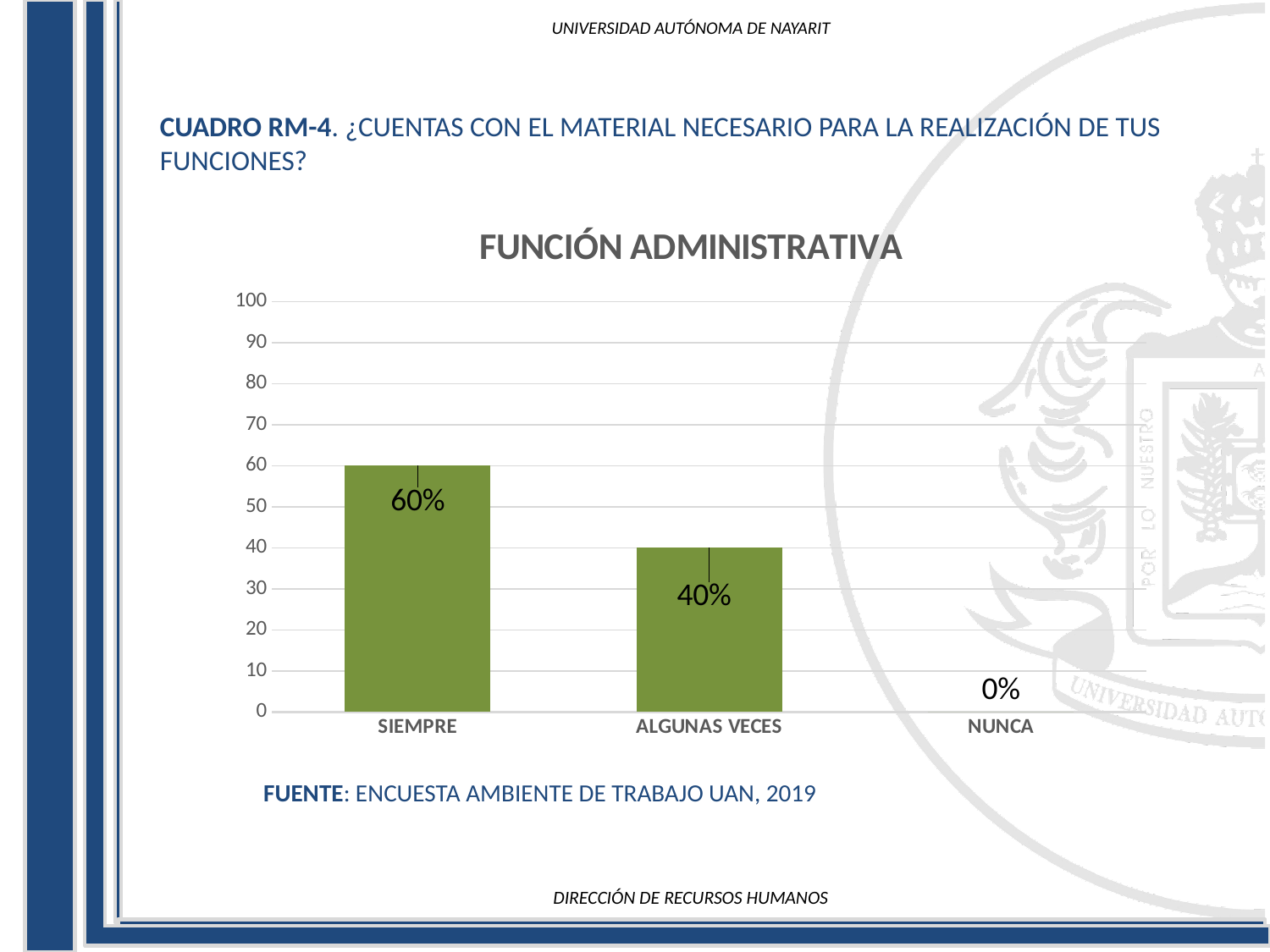
How many categories are shown on the x axis? 3 What is the value for ALGUNAS VECES? 40% Do the values rise or fall from left to right along the x axis? fall Which is larger, the value for SIEMPRE or the value for ALGUNAS VECES? SIEMPRE What is the value for SIEMPRE? 60% Is the value for SIEMPRE greater or less than 50? greater What kind of chart is shown on the slide? bar chart What is the title of the chart? FUNCIÓN ADMINISTRATIVA Which category has the highest value? SIEMPRE Which category has the lowest value? NUNCA What is the difference between the values for SIEMPRE and ALGUNAS VECES? 20% What is the value for NUNCA? 0%